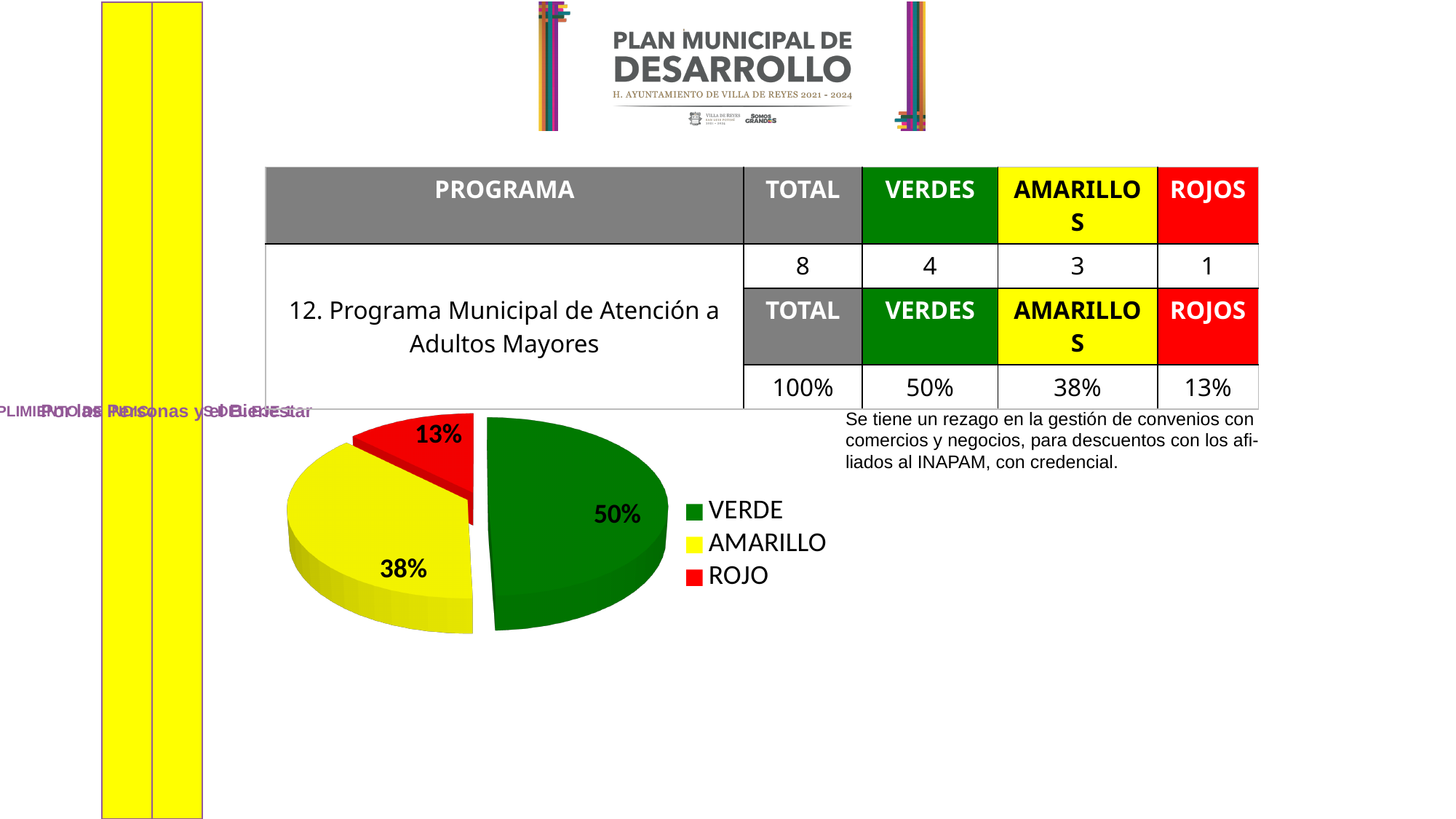
What share of the pie does ROJO represent? 13% What share of the pie does AMARILLO represent? 38% What is the difference in percentage points between the VERDE and AMARILLO slices? 12 What is the difference in percentage points between the AMARILLO and ROJO slices? 25 Which is larger, the AMARILLO slice or the ROJO slice? AMARILLO How many entries does the legend list? 3 Which slice of the pie is the smallest? ROJO How many slices does the pie chart have? 3 What kind of chart is shown on the slide? Pie chart What colour is the slice labelled 38%? Yellow What share of the pie does VERDE represent? 50% Which slice of the pie is the largest? VERDE